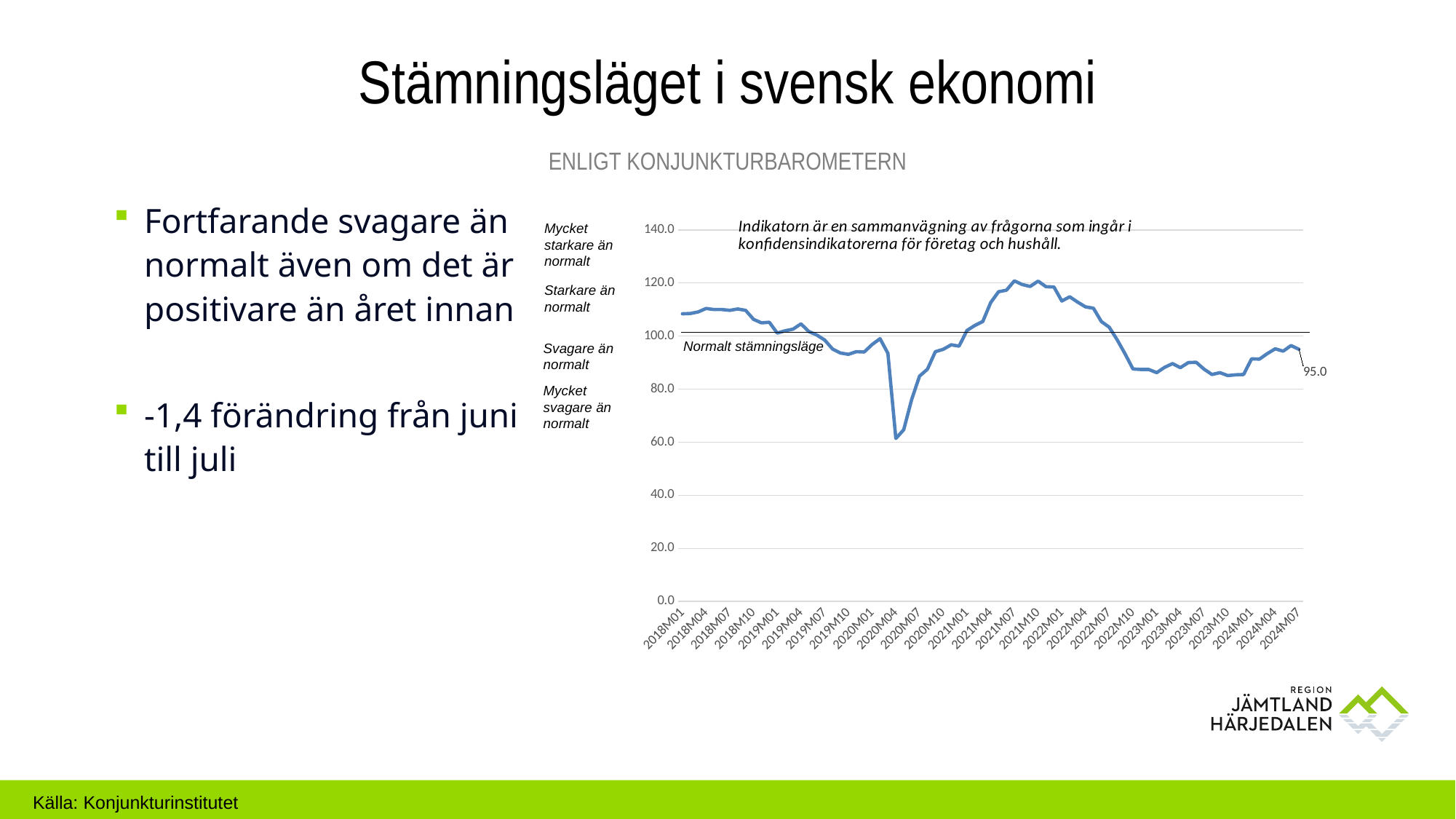
Is the value for 2020M04 greater or less than 80.0? less Around which period does the line reach its lowest point? 2020M04 What is the value of the indicator at 2024M07, the last point on the line? 95.0 Is the value for 2021M07 greater or less than 100.0? greater Is the value for 2023M10 greater or less than 100.0? less Do the values rise or fall between 2020M04 and 2021M07? rise What label is given to the horizontal reference line at 100.0? Normalt stämningsläge What kind of chart is shown on the slide? line chart What is the highest tick value shown on the vertical axis? 140.0 Do the values rise or fall between 2021M10 and 2022M10? fall